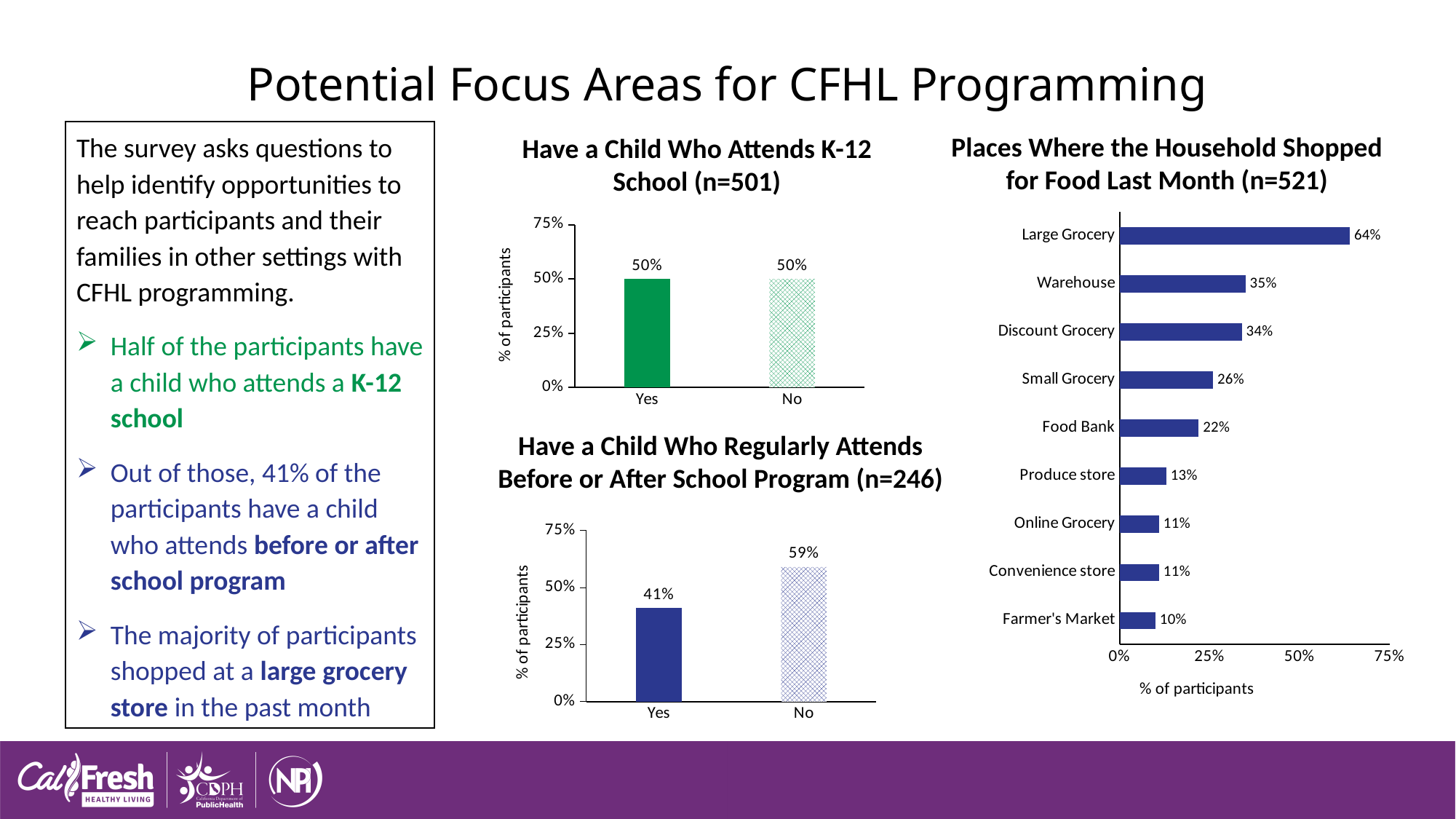
In the 'Have a Child Who Attends K-12 School (n=501)' chart, what is the value for Yes? 50% What kind of chart is the 'Places Where the Household Shopped for Food Last Month (n=521)' chart? Bar chart In the 'Places Where the Household Shopped for Food Last Month (n=521)' chart, is the value for Food Bank greater or less than 25%? less In the 'Have a Child Who Regularly Attends Before or After School Program (n=246)' chart, what is the difference between the No and Yes values? 18% In the 'Places Where the Household Shopped for Food Last Month (n=521)' chart, what is the difference between Large Grocery and Discount Grocery? 30% In the 'Have a Child Who Regularly Attends Before or After School Program (n=246)' chart, what is the value for No? 59% What is the y-axis label of the 'Have a Child Who Attends K-12 School (n=501)' chart? % of participants In the 'Places Where the Household Shopped for Food Last Month (n=521)' chart, what is the value for Warehouse? 35% In the 'Places Where the Household Shopped for Food Last Month (n=521)' chart, how many categories are shown? 9 In the 'Places Where the Household Shopped for Food Last Month (n=521)' chart, which category has the highest value? Large Grocery In the 'Places Where the Household Shopped for Food Last Month (n=521)' chart, which category has the lowest value? Farmer's Market In the 'Have a Child Who Regularly Attends Before or After School Program (n=246)' chart, which is larger, Yes or No? No